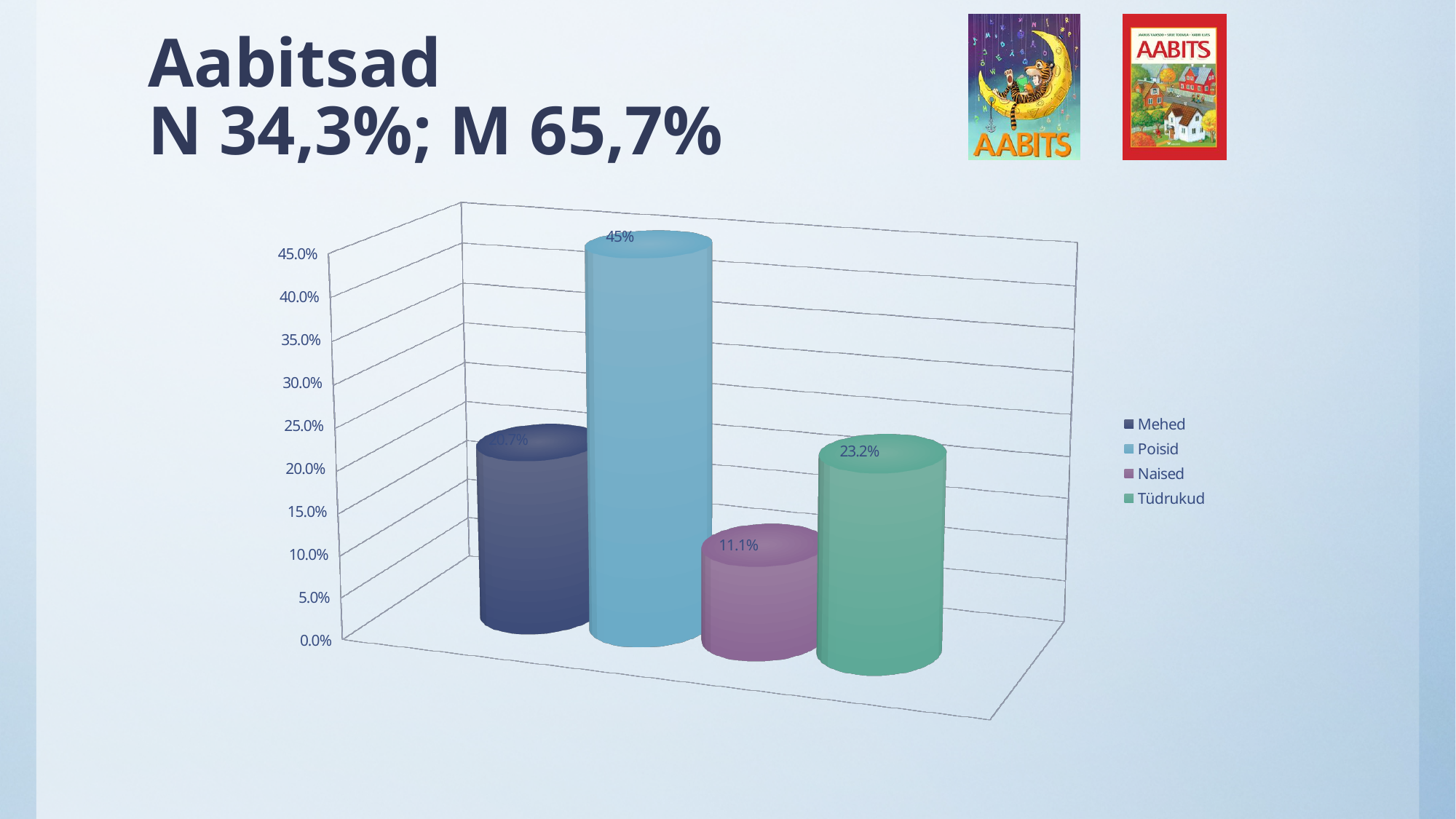
Is the value for Poisid greater or less than 40.0%? greater What is the difference between the values for Tüdrukud and Naised? 12.1% What kind of chart is shown on the slide? bar chart Which is larger, the value for Tüdrukud or the value for Mehed? Tüdrukud What value is shown for Poisid? 45% How many series does the legend list? 4 Which group has the lowest value? Naised What value is shown for Mehed? 20.7% What value is shown for Tüdrukud? 23.2% What is the highest value shown on the vertical axis? 45.0% Which group has the highest value? Poisid What value is shown for Naised? 11.1%